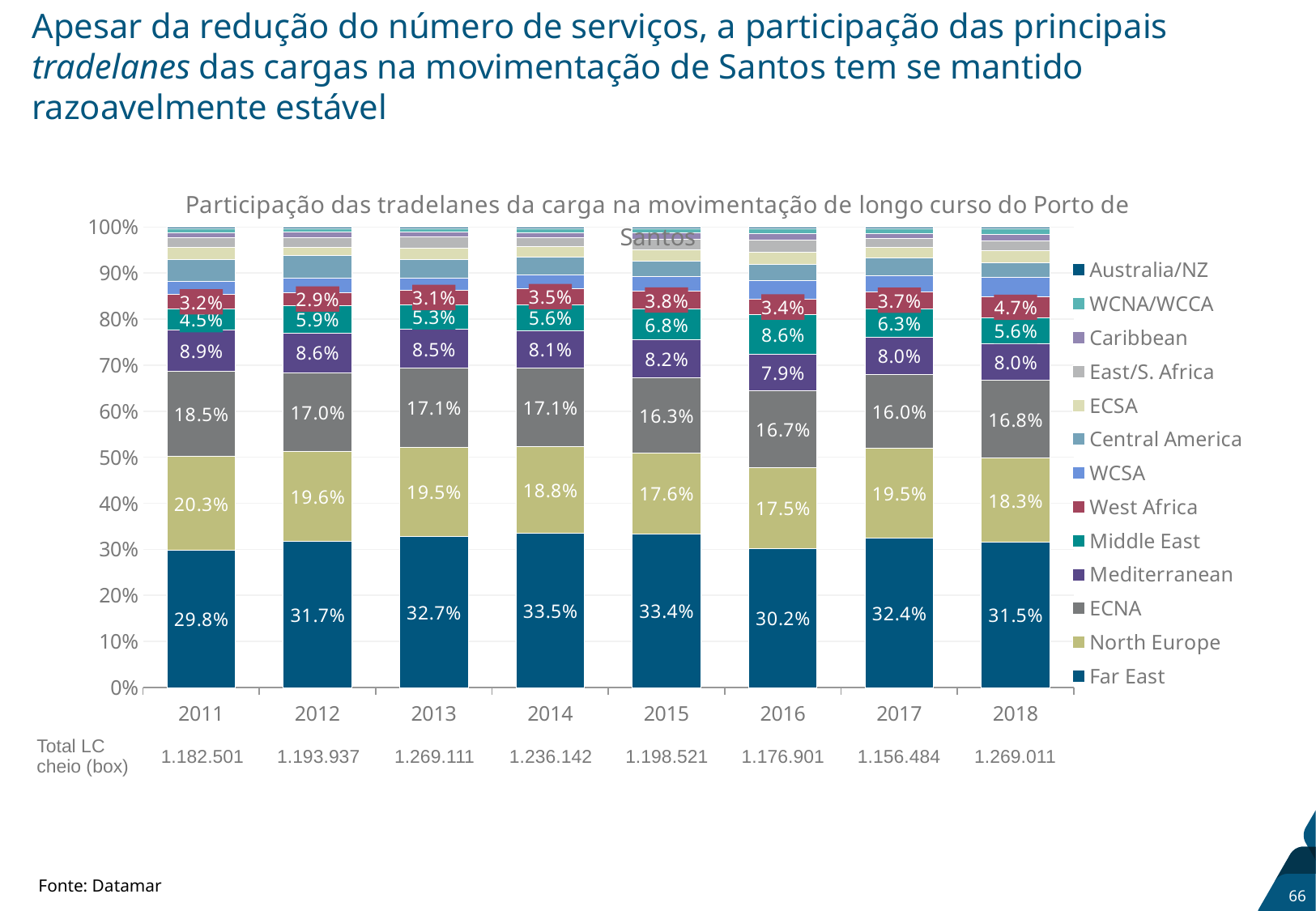
What is the difference between the Far East share in 2014 and in 2011? 3.7 percentage points Which is larger, the ECNA share in 2011 or in 2017? 2011 What is the Far East share in 2014? 33.5% What type of chart is shown on the slide? Stacked bar chart What source is cited for the chart data? Datamar How many series does the chart legend list? 13 What is the North Europe share in 2016? 17.5% In which year is the Far East share lowest? 2011 In which year is the Middle East share highest? 2016 In which year is the West Africa share highest? 2018 How many years are shown on the x axis of the chart? 8 What is the Middle East share in 2018? 5.6%